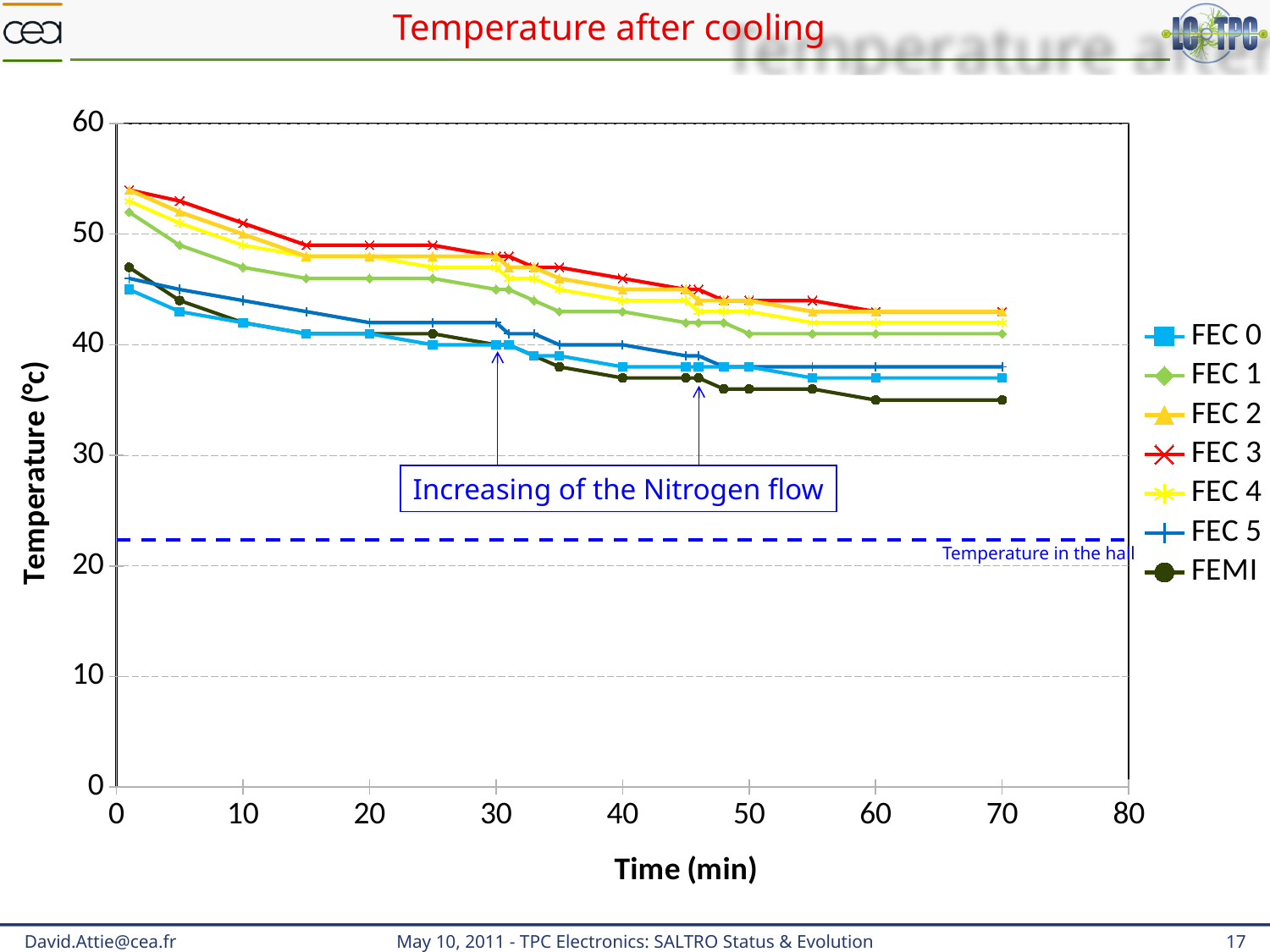
How many series does the legend list? 7 Do the temperature values rise or fall as time increases along the x axis? fall Is the value for FEC 0 at 70 min greater or less than 40? less Is the value for FEC 3 at the start of the measurement (time near 0 min) greater or less than 50? greater What does the dashed horizontal line on the chart represent? Temperature in the hall At the start of the measurement, which series has the lowest temperature? FEC 0 At 70 min, which series has the lowest temperature? FEMI What is the title of the chart? Temperature after cooling Is the value for FEC 2 at 70 min greater or less than 40? greater At 70 min, which is larger: the value for FEC 5 or the value for FEMI? FEC 5 What kind of chart is shown on the slide? line chart